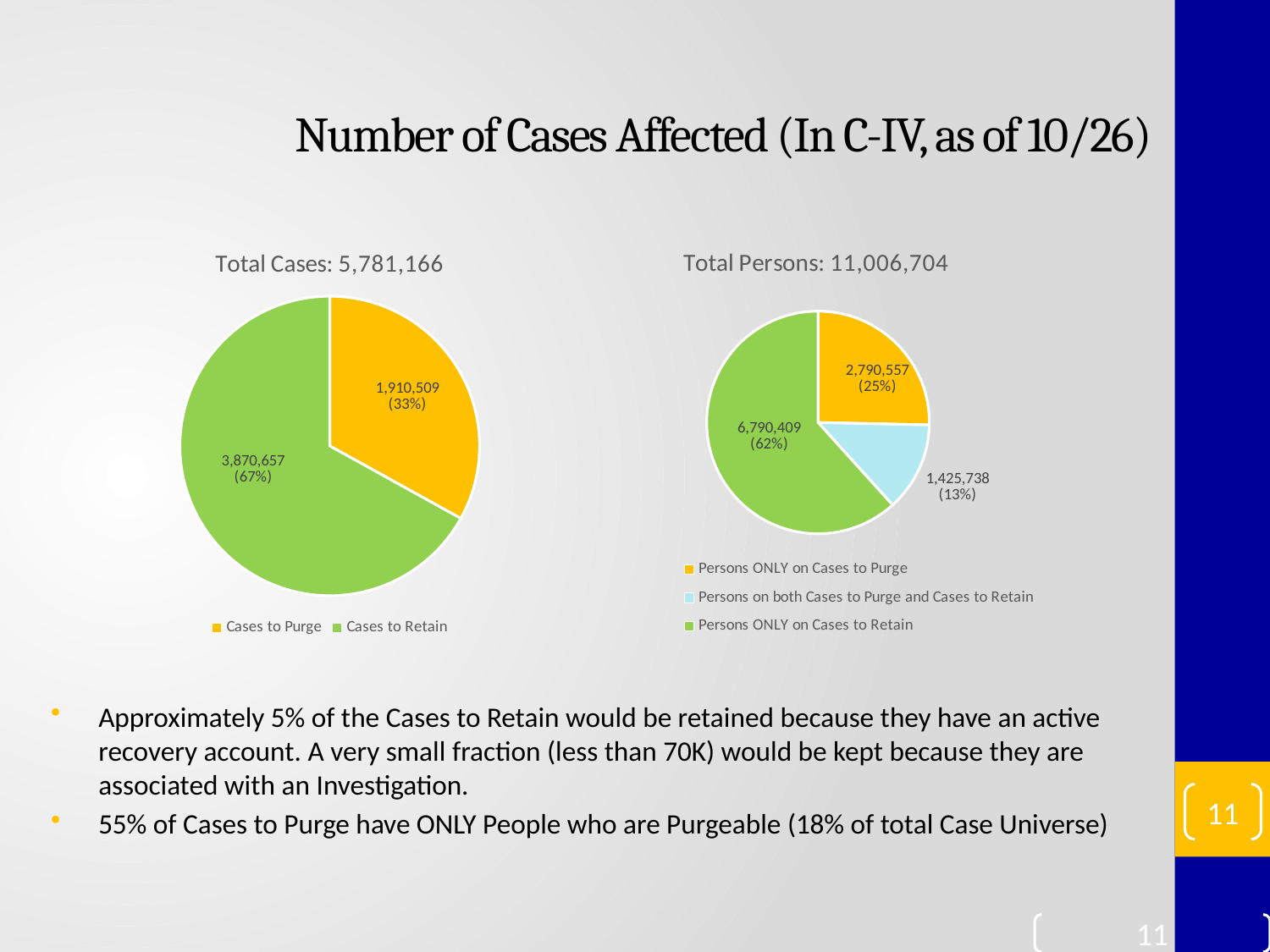
In the 'Total Persons: 11,006,704' pie chart, what is the value for Persons ONLY on Cases to Retain? 6,790,409 In the 'Total Cases: 5,781,166' pie chart, what is the difference between Cases to Retain and Cases to Purge? 1,960,148 In the 'Total Cases: 5,781,166' pie chart, what share of the pie is Cases to Retain? 67% In the 'Total Persons: 11,006,704' pie chart, what colour represents Persons on both Cases to Purge and Cases to Retain? Light blue In the 'Total Persons: 11,006,704' pie chart, which category has the smallest slice? Persons on both Cases to Purge and Cases to Retain In the 'Total Persons: 11,006,704' pie chart, what is the value for Persons on both Cases to Purge and Cases to Retain? 1,425,738 How many slices does the 'Total Persons: 11,006,704' pie chart have? 3 In the 'Total Cases: 5,781,166' pie chart, what is the value for Cases to Purge? 1,910,509 In the 'Total Persons: 11,006,704' pie chart, what share of the pie is Persons ONLY on Cases to Purge? 25% What type of chart is used for 'Total Cases: 5,781,166'? Pie chart In the 'Total Cases: 5,781,166' pie chart, which slice is larger, Cases to Purge or Cases to Retain? Cases to Retain In the 'Total Persons: 11,006,704' pie chart, which category has the largest slice? Persons ONLY on Cases to Retain